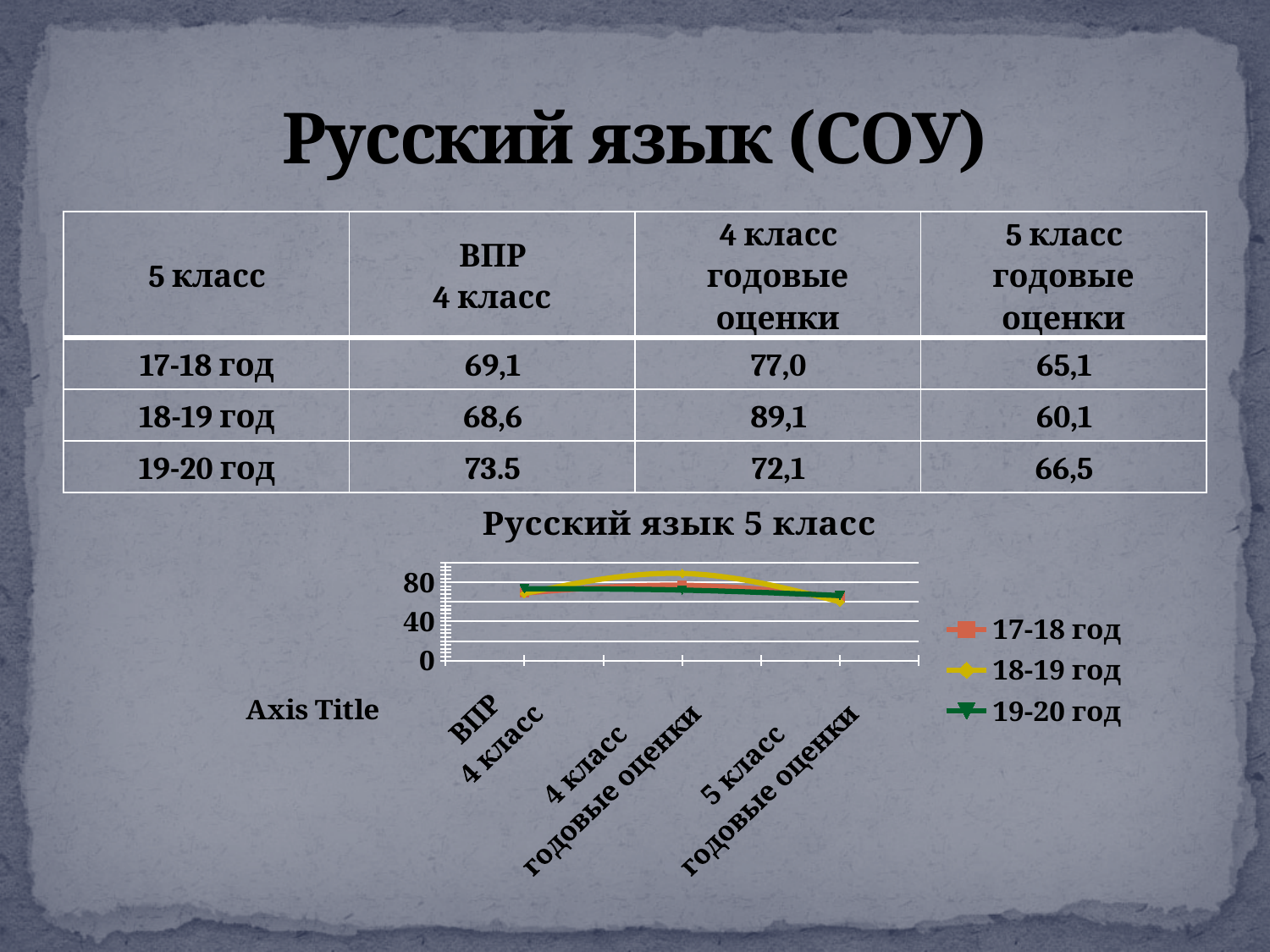
What is the difference between the 18-19 год and 17-18 год values at 4 класс годовые оценки? 12,1 What is the title of the chart? Русский язык 5 класс What is the value for 18-19 год at 4 класс годовые оценки? 89,1 How many categories are shown along the x axis of the chart? 3 For the 18-19 год series, which category has the highest value? 4 класс годовые оценки At 4 класс годовые оценки, which series has the larger value: 18-19 год or 17-18 год? 18-19 год What is the value for 19-20 год at ВПР 4 класс? 73.5 What kind of chart is shown on the slide? line chart Is the value for 17-18 год at 5 класс годовые оценки greater or less than 80? less Which series is plotted in yellow in the chart? 18-19 год How many series does the chart legend list? 3 Is the value for 18-19 год at 4 класс годовые оценки greater or less than 80? greater